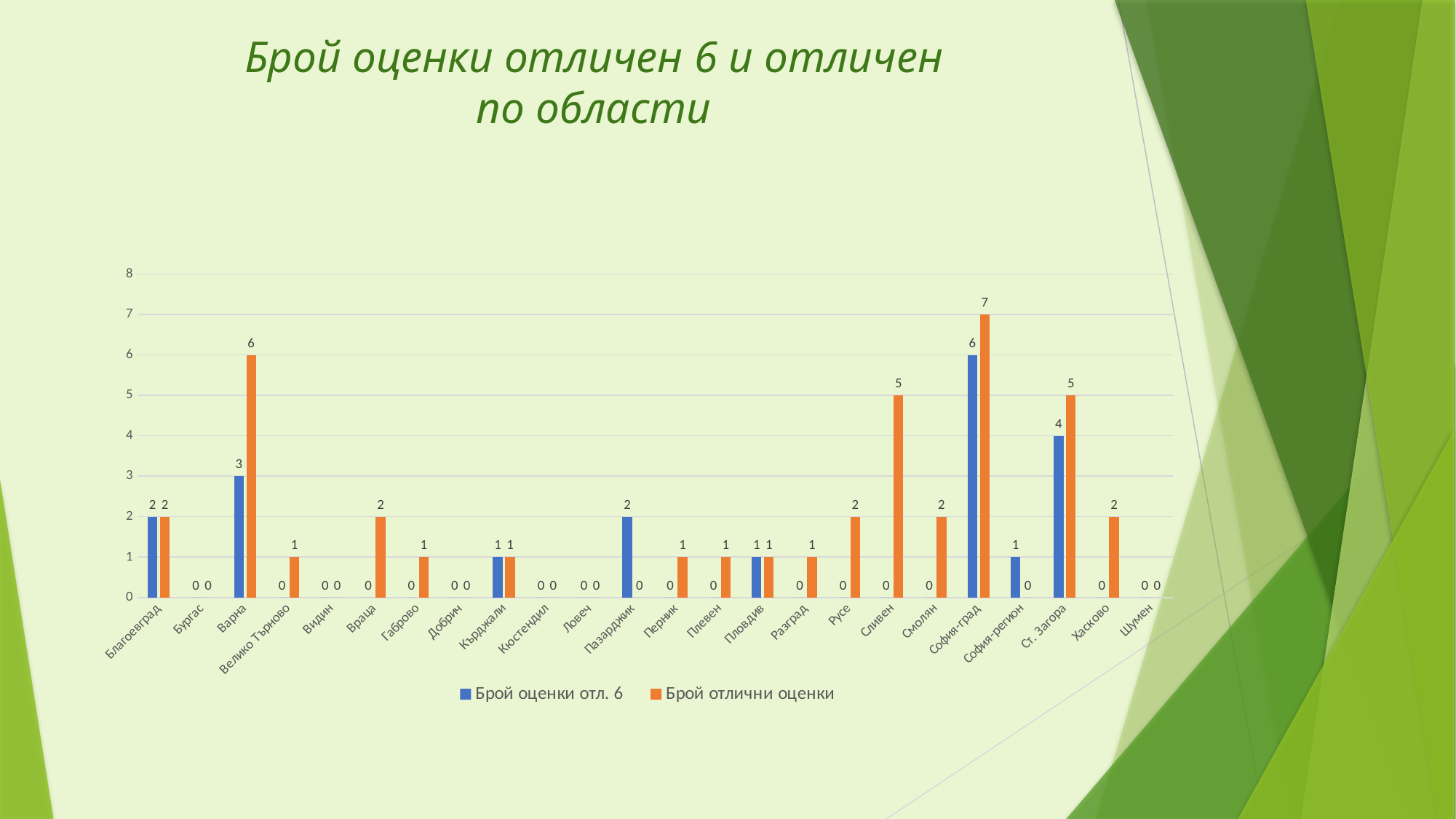
What is the value of 'Брой оценки отл. 6' for Пазарджик? 2 Which region has the highest value for 'Брой отлични оценки'? София-град How many series does the legend list? 2 What type of chart is shown on the slide? bar chart What is the title of the chart? Брой оценки отличен 6 и отличен по области Which is larger for Ст. Загора: 'Брой оценки отл. 6' or 'Брой отлични оценки'? Брой отлични оценки What is the value of 'Брой оценки отл. 6' for Варна? 3 What is the value of 'Брой отлични оценки' for Сливен? 5 Which region has the highest value for 'Брой оценки отл. 6'? София-град How many regions (categories) are shown on the x axis? 24 What is the difference between 'Брой отлични оценки' and 'Брой оценки отл. 6' for Варна? 3 What is the value of 'Брой отлични оценки' for София-град? 7